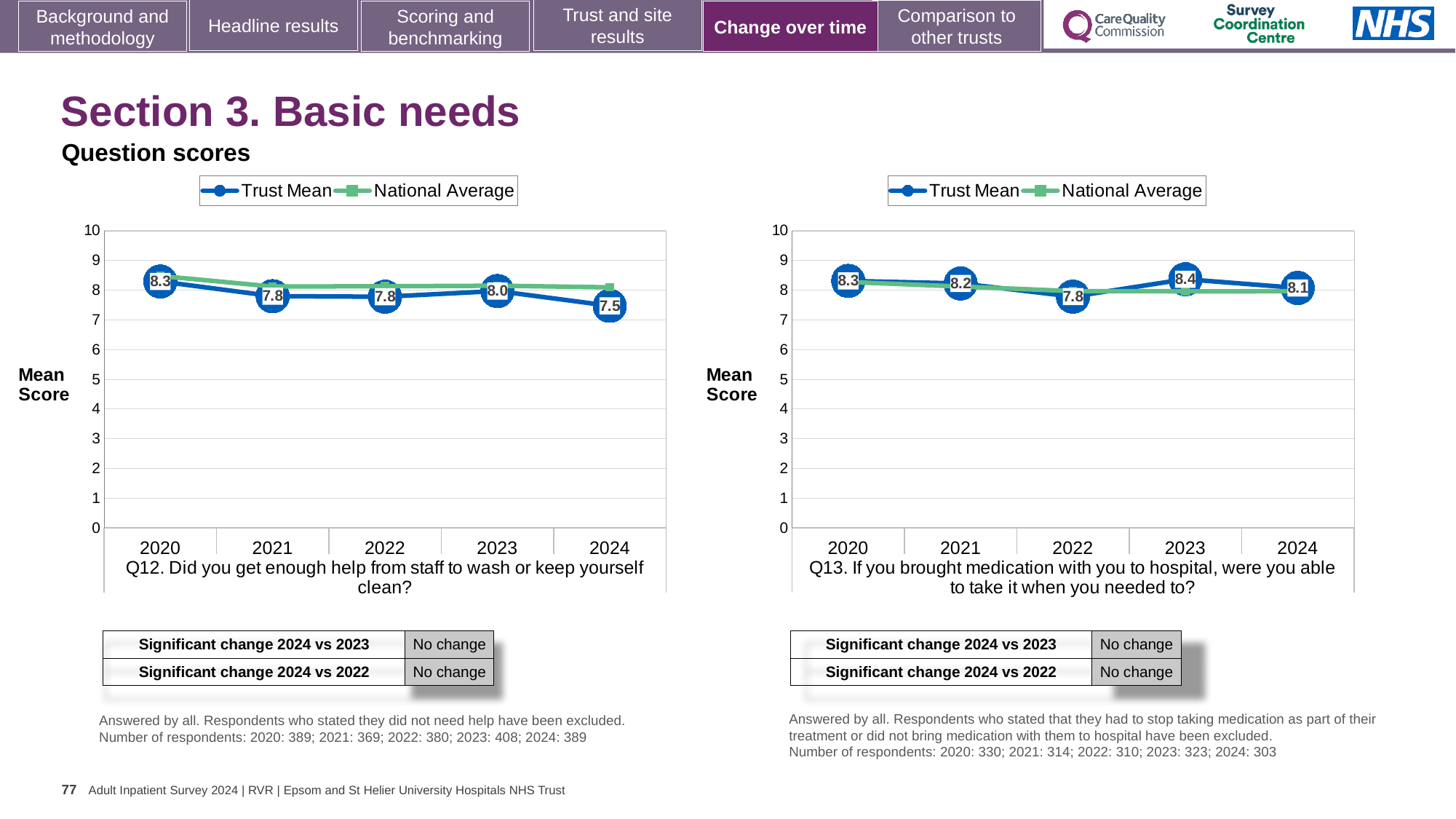
In the Q12 chart, what is the difference between the Trust Mean for 2020 and 2024? 0.8 In the Q13 chart, what is the Trust Mean for 2023? 8.4 What type of chart is used for Q13? Line chart In the Q12 chart, which year has the lowest Trust Mean? 2024 In the Q13 chart, which year has the highest Trust Mean? 2023 How many series does the legend of the Q12 chart list? 2 In the Q13 chart, is the Trust Mean for 2022 larger or smaller than the Trust Mean for 2024? smaller In the Q13 chart, which year has the lowest Trust Mean? 2022 In the Q12 chart, what is the Trust Mean for 2024? 7.5 In the Q12 chart, how many years are plotted on the x axis? 5 In the Q13 chart, what is the difference between the Trust Mean for 2023 and 2022? 0.6 In the Q12 chart, what is the Trust Mean for 2020? 8.3